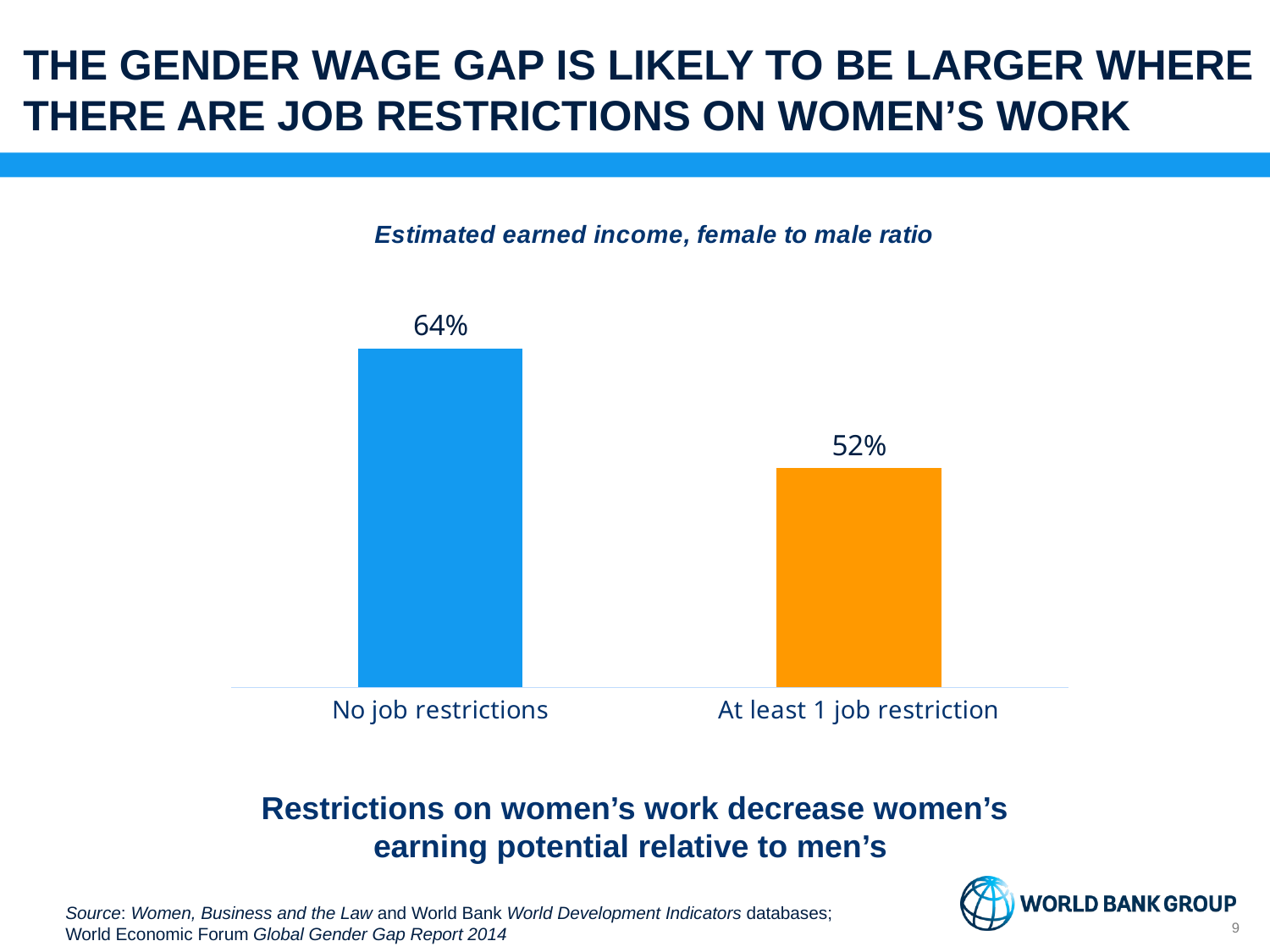
What kind of chart is shown on the slide? bar chart Is the value for 'At least 1 job restriction' larger or smaller than the value for 'No job restrictions'? smaller Do the values rise or fall from left to right across the categories? fall What colour is the bar for 'At least 1 job restriction'? orange What is the estimated earned income female to male ratio for 'At least 1 job restriction'? 52% Which category has the lower female to male earned income ratio? At least 1 job restriction What is the estimated earned income female to male ratio for 'No job restrictions'? 64% What is the title of the chart? Estimated earned income, female to male ratio Which category has the higher female to male earned income ratio? No job restrictions What is the difference in percentage points between the 'No job restrictions' and 'At least 1 job restriction' bars? 12 percentage points How many categories are shown in the chart? 2